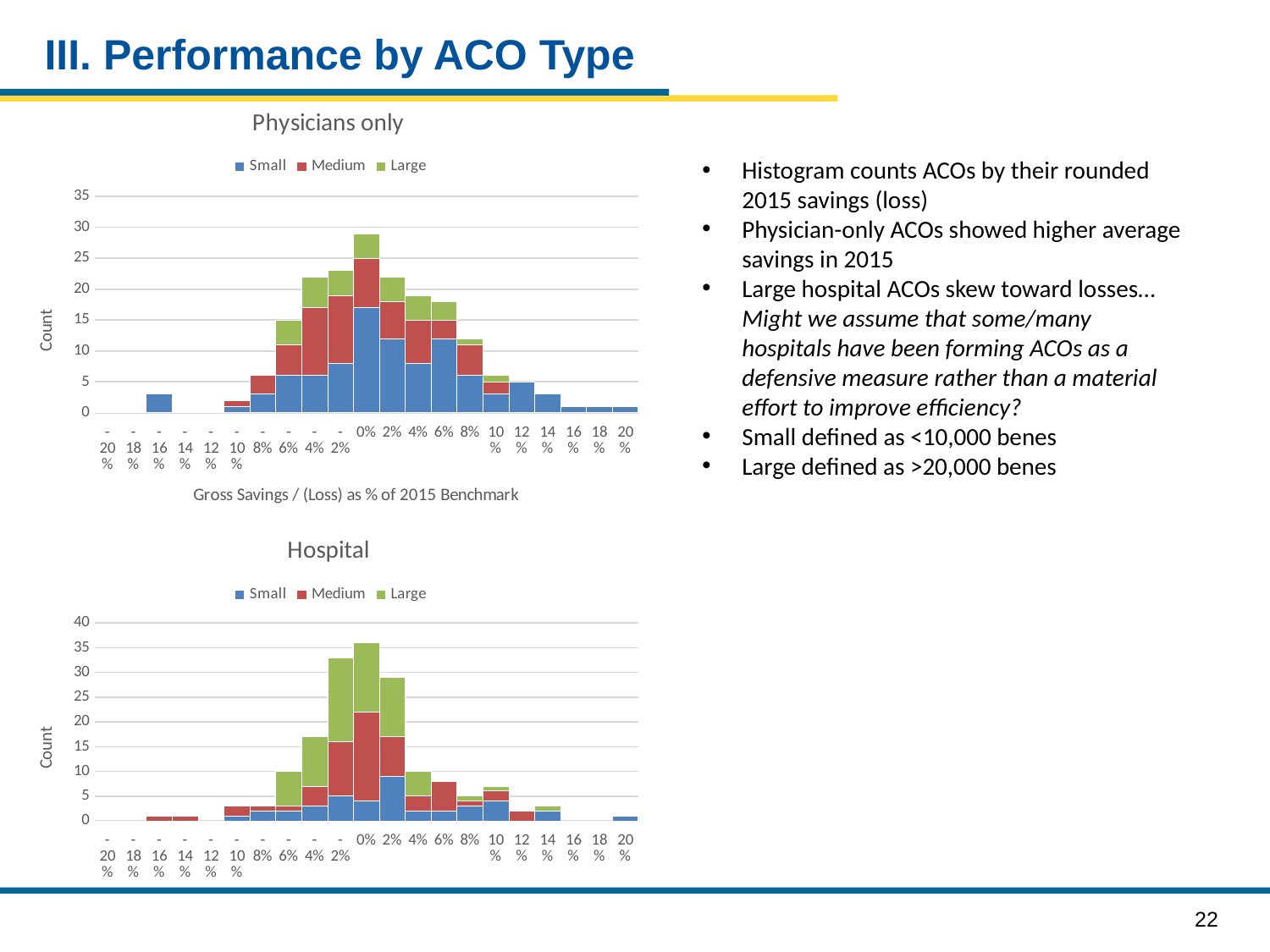
What kind of chart is the Physicians only chart? Stacked bar chart In the Hospital chart, is the total count for the -2% bar greater or less than 30? greater How many categories are shown on the x axis of the Physicians only chart? 21 In the Physicians only chart, is the total count for the 0% bar greater or less than 25? greater What is the y-axis label of the Hospital chart? Count What is the x-axis title of the Physicians only chart? Gross Savings / (Loss) as % of 2015 Benchmark How many series does the legend of the Hospital chart list? 3 In the Hospital chart, which stacked bar is taller, -4% or 6%? -4% In the Physicians only chart, which stacked bar is taller, -4% or 8%? -4% In the Physicians only chart, is the total count for the -16% bar greater or less than 5? less In the Physicians only chart, which category has the tallest stacked bar? 0% In the Hospital chart, which category has the tallest stacked bar? 0%